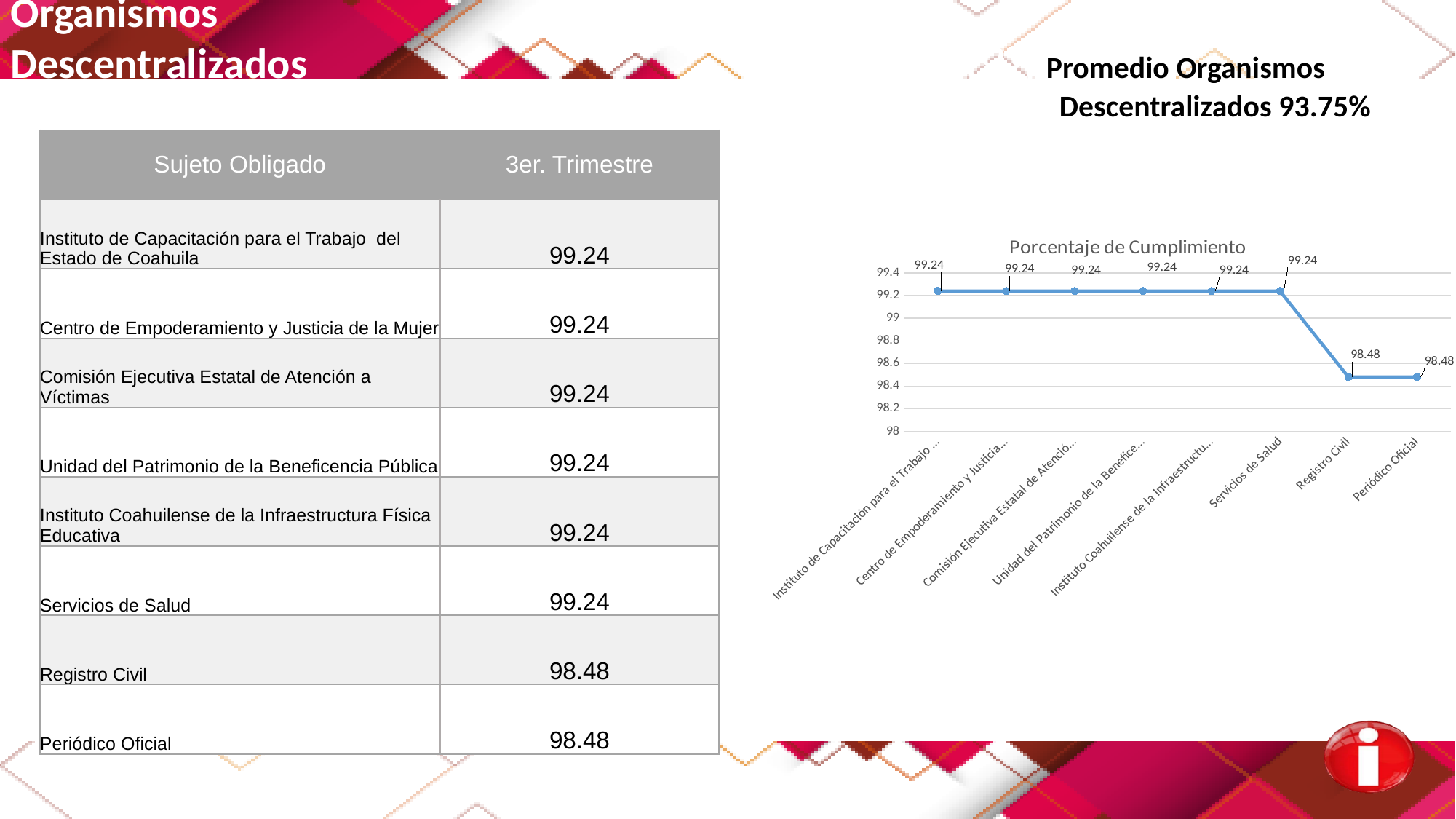
What is the value for Periódico Oficial in the chart? 98.48 How many data points are plotted in the chart? 8 What type of chart is shown on the slide? line chart What is the difference between the value for Servicios de Salud and the value for Registro Civil? 0.76 What is the value for Registro Civil in the chart? 98.48 Do the values rise or fall from Servicios de Salud to Registro Civil? fall What is the lowest value shown on the chart's vertical axis? 98 Which is larger, the value for Servicios de Salud or the value for Periódico Oficial? Servicios de Salud Is the value for Servicios de Salud greater or less than 99? greater What is the value for Servicios de Salud in the chart? 99.24 Is the value for Registro Civil greater or less than 99? less What is the title of the chart? Porcentaje de Cumplimiento